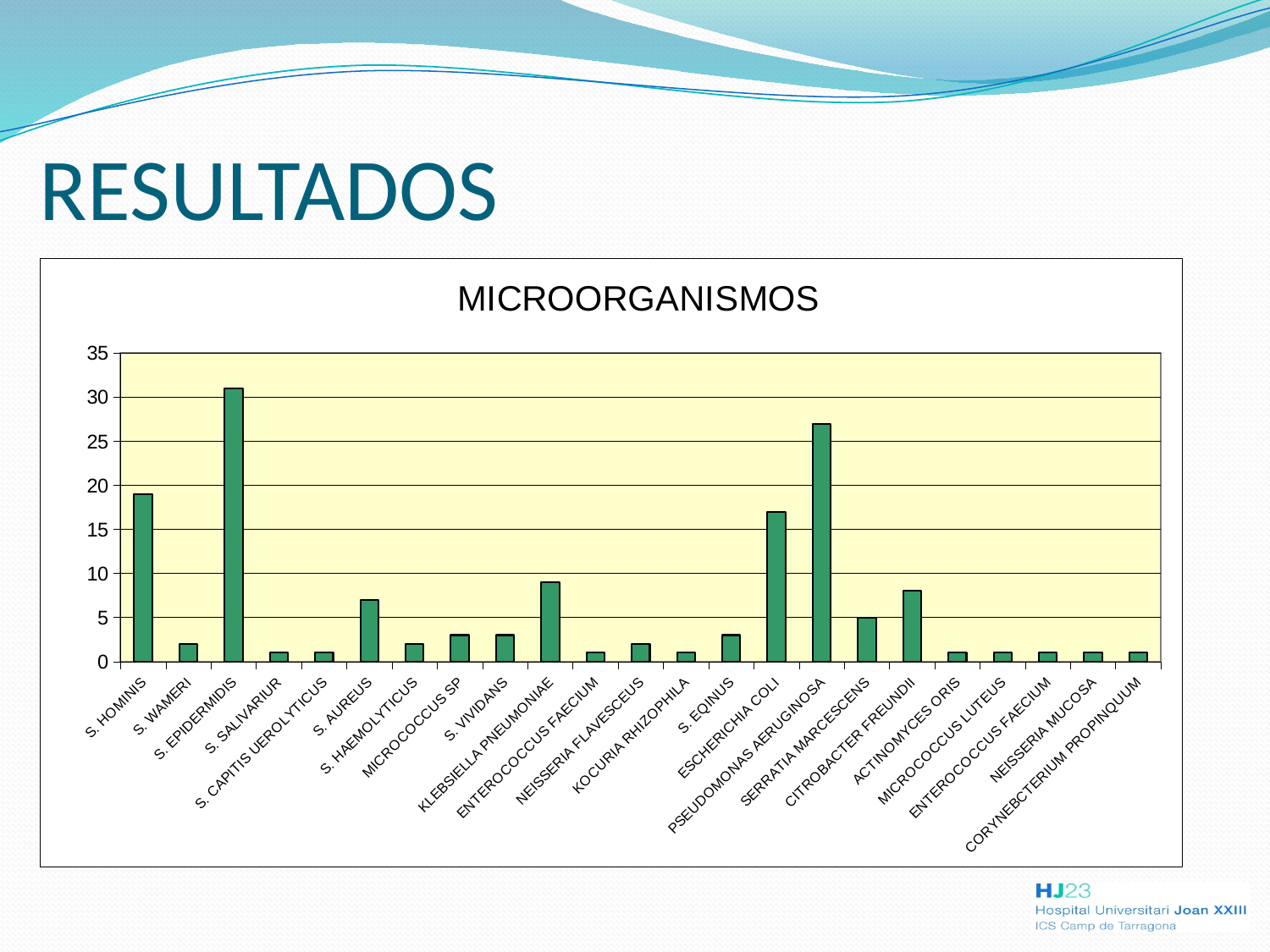
Which microorganism has the highest bar in the chart? S. EPIDERMIDIS Is the value for ESCHERICHIA COLI greater or less than 15? greater Is the value for PSEUDOMONAS AERUGINOSA greater or less than 25? greater Which has a larger value, PSEUDOMONAS AERUGINOSA or ESCHERICHIA COLI? PSEUDOMONAS AERUGINOSA Is the value for S. EPIDERMIDIS greater or less than 30? greater Which has a larger value, CITROBACTER FREUNDII or S. WAMERI? CITROBACTER FREUNDII What is the title of the chart? MICROORGANISMOS Which has a larger value, S. HOMINIS or S. AUREUS? S. HOMINIS What kind of chart is shown on the slide? bar chart How many microorganism categories are shown on the x axis? 23